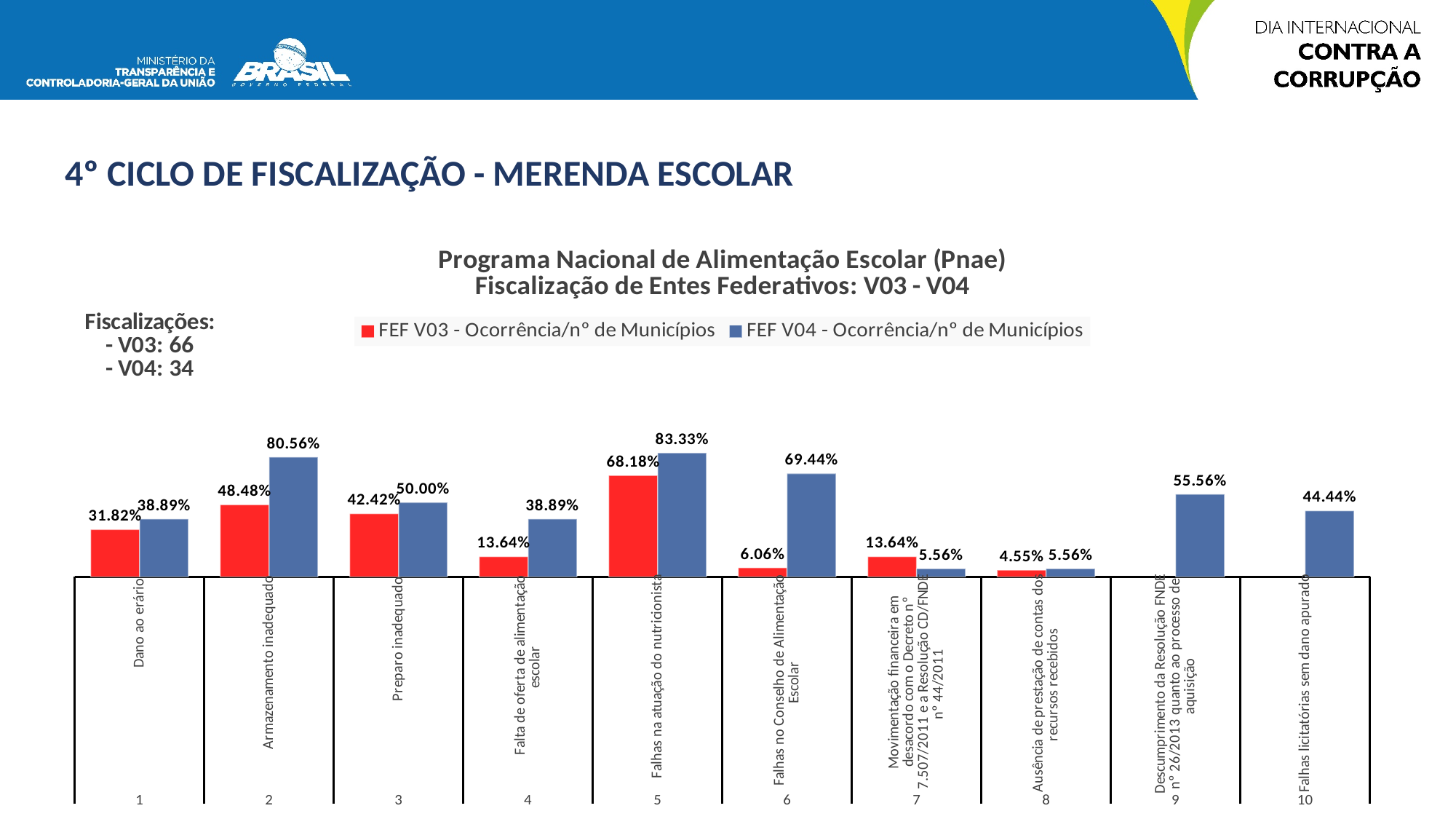
For Movimentação financeira em desacordo com o Decreto nº 7.507/2011, which series has the larger value, FEF V03 or FEF V04? FEF V03 What is the FEF V04 value for Falhas licitatórias sem dano apurado? 44.44% What is the FEF V03 value for Falhas no Conselho de Alimentação Escolar? 6.06% Which category has the highest FEF V04 value? Falhas na atuação do nutricionista How many series does the legend list? 2 What is the FEF V03 value for Falhas na atuação do nutricionista? 68.18% How many categories are shown on the x axis? 10 Which category has the lowest FEF V03 value among those with a V03 bar? Ausência de prestação de contas dos recursos recebidos Which colour represents the FEF V03 series in the chart? Red What kind of chart is shown on the slide? Bar chart What is the FEF V04 value for Armazenamento inadequado? 80.56% What is the difference between the FEF V04 and FEF V03 values for Falhas no Conselho de Alimentação Escolar? 63.38%